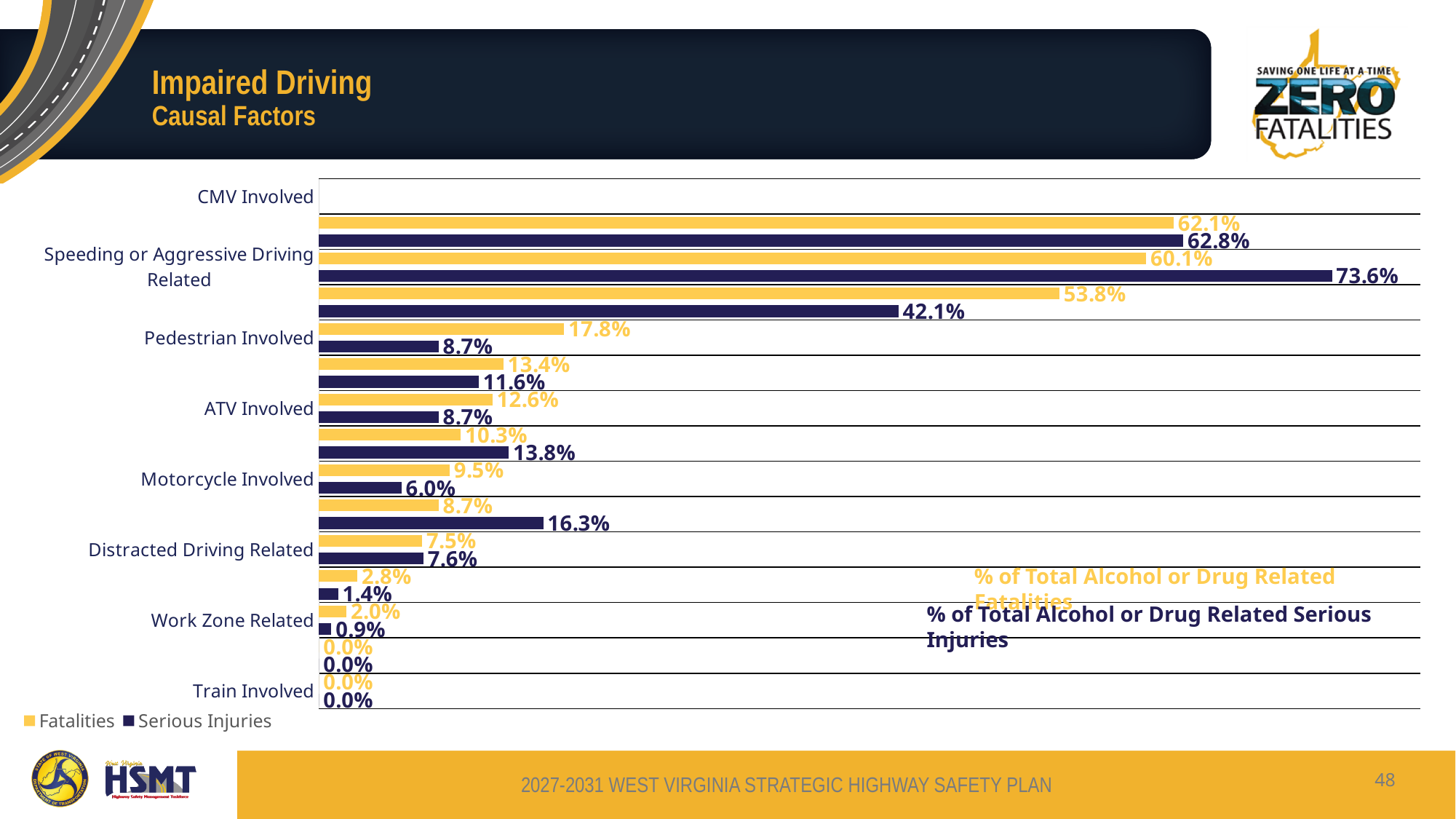
What is the highest Fatalities value shown on the chart? 62.1% What is the highest Serious Injuries value shown on the chart? 73.6% What is the Fatalities value for Train Involved? 0.0% What is the Serious Injuries value for Motorcycle Involved? 6.0% What type of chart is shown on the slide? Horizontal bar chart How many series does the chart legend list? 2 For Work Zone Related, which is larger: the Fatalities value or the Serious Injuries value? Fatalities For Distracted Driving Related, what is the difference between the Serious Injuries value and the Fatalities value? 0.1 percentage points What is the Serious Injuries value for Speeding or Aggressive Driving Related? 73.6% What are the two series named in the chart legend? Fatalities and Serious Injuries What is the Fatalities value for Speeding or Aggressive Driving Related? 60.1% What is the Fatalities value for Pedestrian Involved? 17.8%